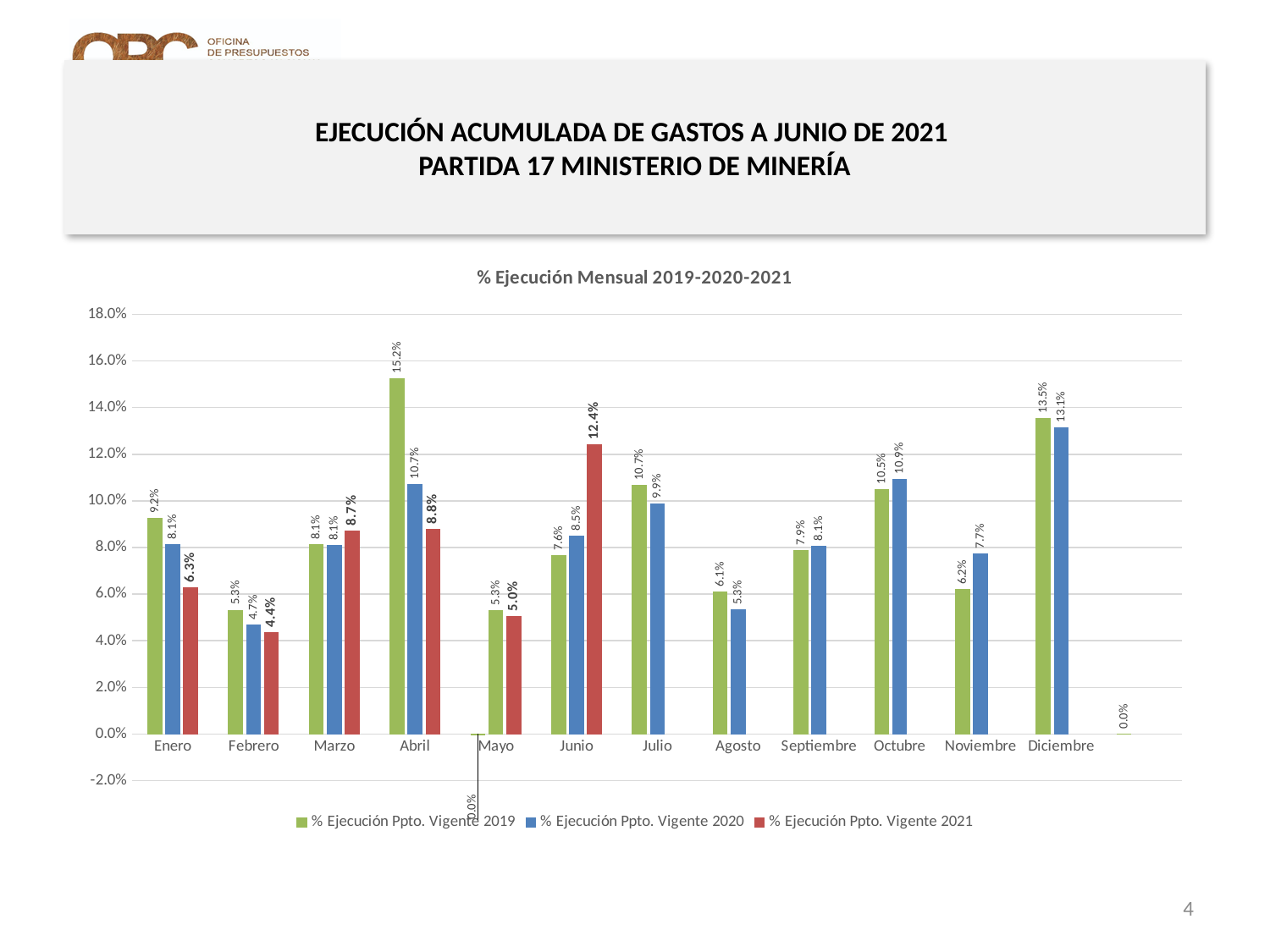
What is the value for % Ejecución Ppto. Vigente 2019 in Abril? 15.2% Which month has the highest value for % Ejecución Ppto. Vigente 2019? Abril Which month has the lowest value for % Ejecución Ppto. Vigente 2021? Febrero What is the difference between the 2021 and 2019 values in Junio? 4.8 percentage points What type of chart is shown on the slide? Bar chart What is the value for % Ejecución Ppto. Vigente 2020 in Diciembre? 13.1% What is the difference between the 2019 and 2020 values in Abril? 4.5 percentage points How many series does the legend list? 3 Which month has the highest value for % Ejecución Ppto. Vigente 2021? Junio How many months are shown on the x axis? 12 In Octubre, which series has the larger value: 2019 or 2020? % Ejecución Ppto. Vigente 2020 What is the value for % Ejecución Ppto. Vigente 2021 in Junio? 12.4%